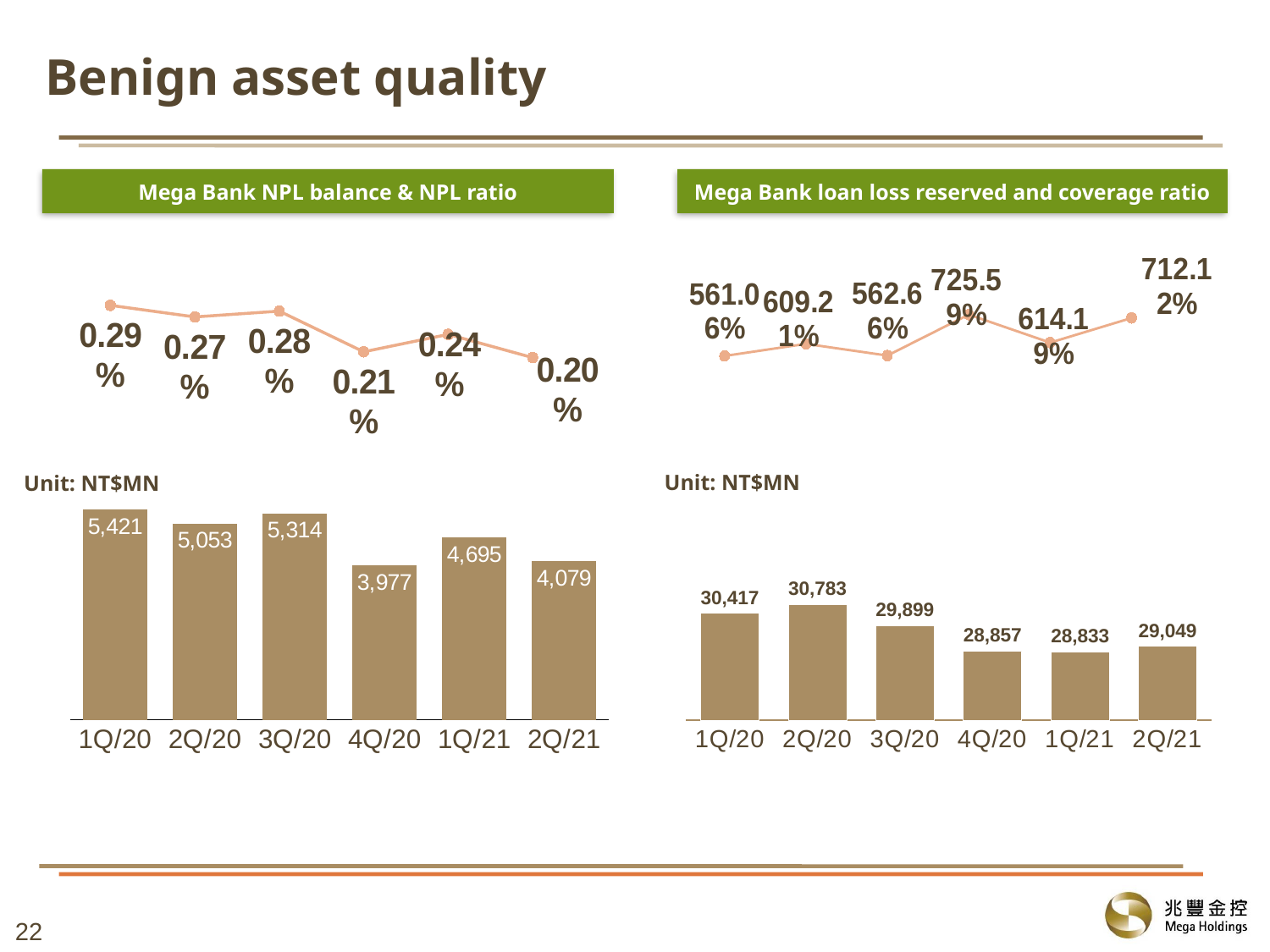
In the Mega Bank NPL ratio line chart, which quarter has the highest NPL ratio? 1Q/20 How many quarters are shown on the x axis of the Mega Bank NPL balance bar chart? 6 In the Mega Bank NPL balance bar chart, what is the NPL balance for 1Q/20? 5,421 In the Mega Bank NPL balance bar chart, what is the difference between the NPL balance in 1Q/20 and 2Q/21? 1,342 In the Mega Bank NPL ratio line chart, is the NPL ratio higher in 1Q/21 or 4Q/20? 1Q/21 In the Mega Bank coverage ratio line chart, which quarter has the highest coverage ratio? 4Q/20 In the Mega Bank NPL balance bar chart, which quarter has the lowest NPL balance? 4Q/20 In the Mega Bank loan loss reserved bar chart, what is the difference between the loan loss reserve in 2Q/20 and 1Q/21? 1,950 In the Mega Bank NPL ratio line chart, what is the NPL ratio for 2Q/21? 0.20% In the Mega Bank loan loss reserved bar chart, what is the loan loss reserve for 2Q/20? 30,783 In the Mega Bank loan loss reserved bar chart, which quarter has the lowest loan loss reserve? 1Q/21 What unit is stated for the Mega Bank loan loss reserved bar chart? NT$MN